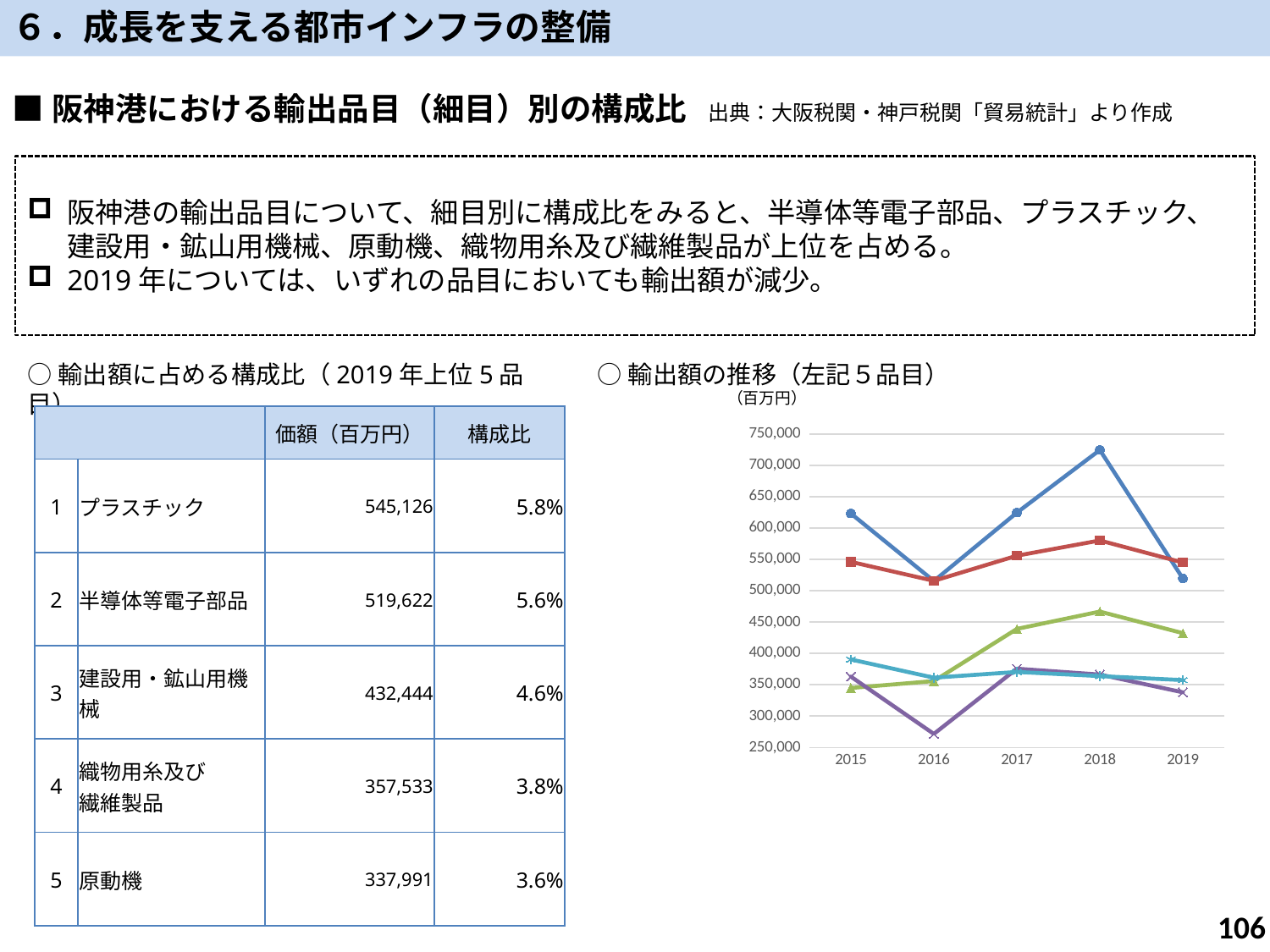
What unit is shown above the y axis of the 輸出額の推移 chart? 百万円 What kind of chart is the 輸出額の推移 chart on the right? line chart In the 輸出額の推移 chart, which line has the larger value in 2015, the blue line or the red line? blue line In the 輸出額の推移 chart, does the green line rise or fall from 2016 to 2018? rise In the 輸出額の推移 chart, is the value of the blue line in 2018 greater or less than 700,000? greater How many lines are plotted in the 輸出額の推移 chart? 5 In the 輸出額の推移 chart, does the blue line rise or fall from 2018 to 2019? fall In the 輸出額の推移 chart, is the value of the purple line in 2016 greater or less than 300,000? less In the 輸出額の推移 chart, is the value of the green line in 2018 greater or less than 450,000? greater In the 輸出額の推移 chart, in which year does the blue line reach its highest value? 2018 In the 輸出額の推移 chart, in which year does the purple line reach its lowest value? 2016 How many years are shown on the x axis of the 輸出額の推移 chart? 5